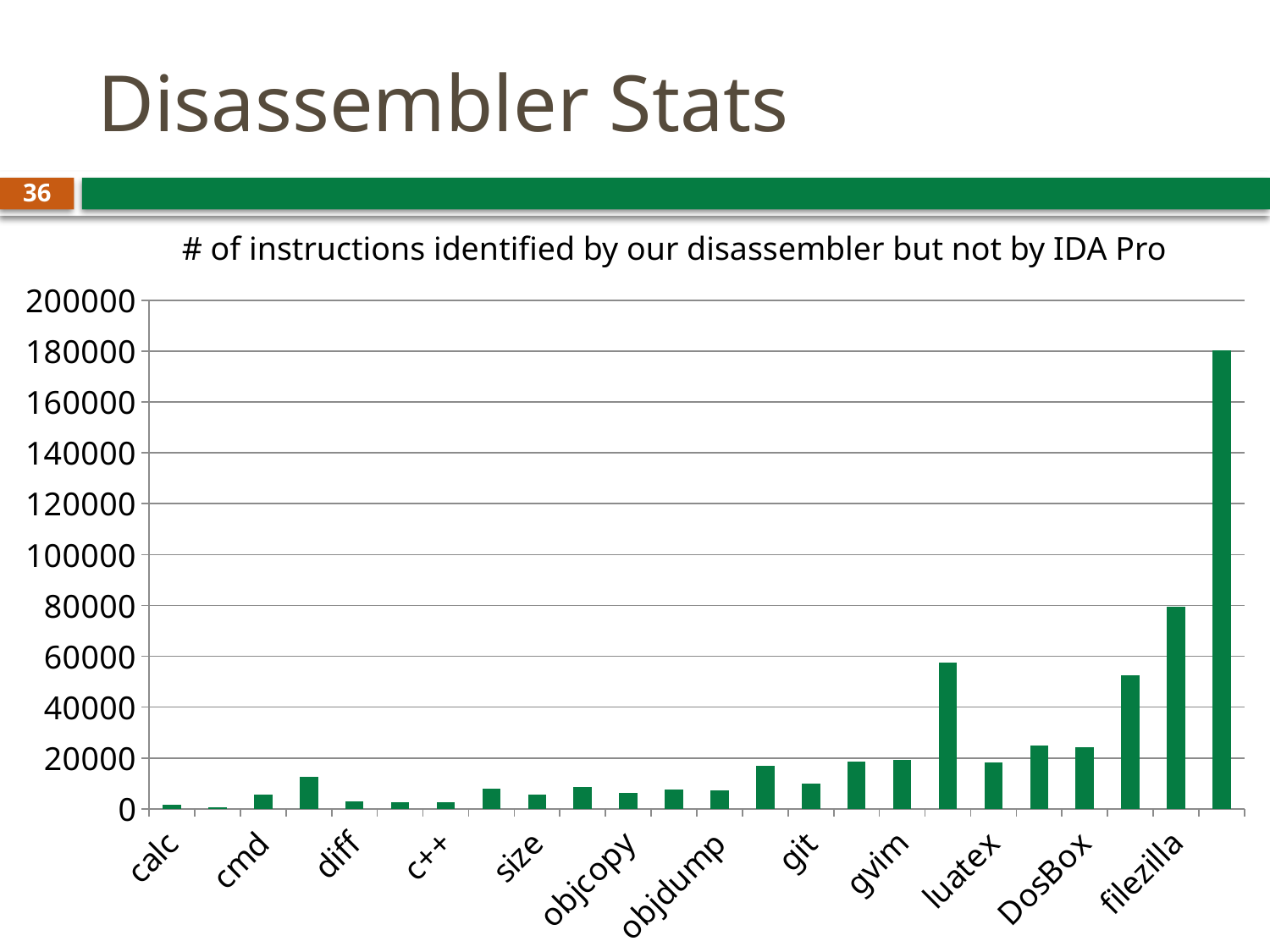
What kind of chart is shown on the slide? bar chart What is the maximum value shown on the y axis? 200000 How many category labels are printed along the x axis of the chart? 12 Is the value of the rightmost bar greater or less than 160000? greater Which bar in the chart is the highest? the rightmost bar Which is larger, the rightmost bar or the second bar from the right? the rightmost bar How many bars are plotted in the chart? 24 Is the value of the leftmost bar greater or less than 20000? less Do the bar values generally rise or fall from left to right along the x axis? rise Is the value of the rightmost bar greater or less than 200000? less What is the title of the chart? # of instructions identified by our disassembler but not by IDA Pro